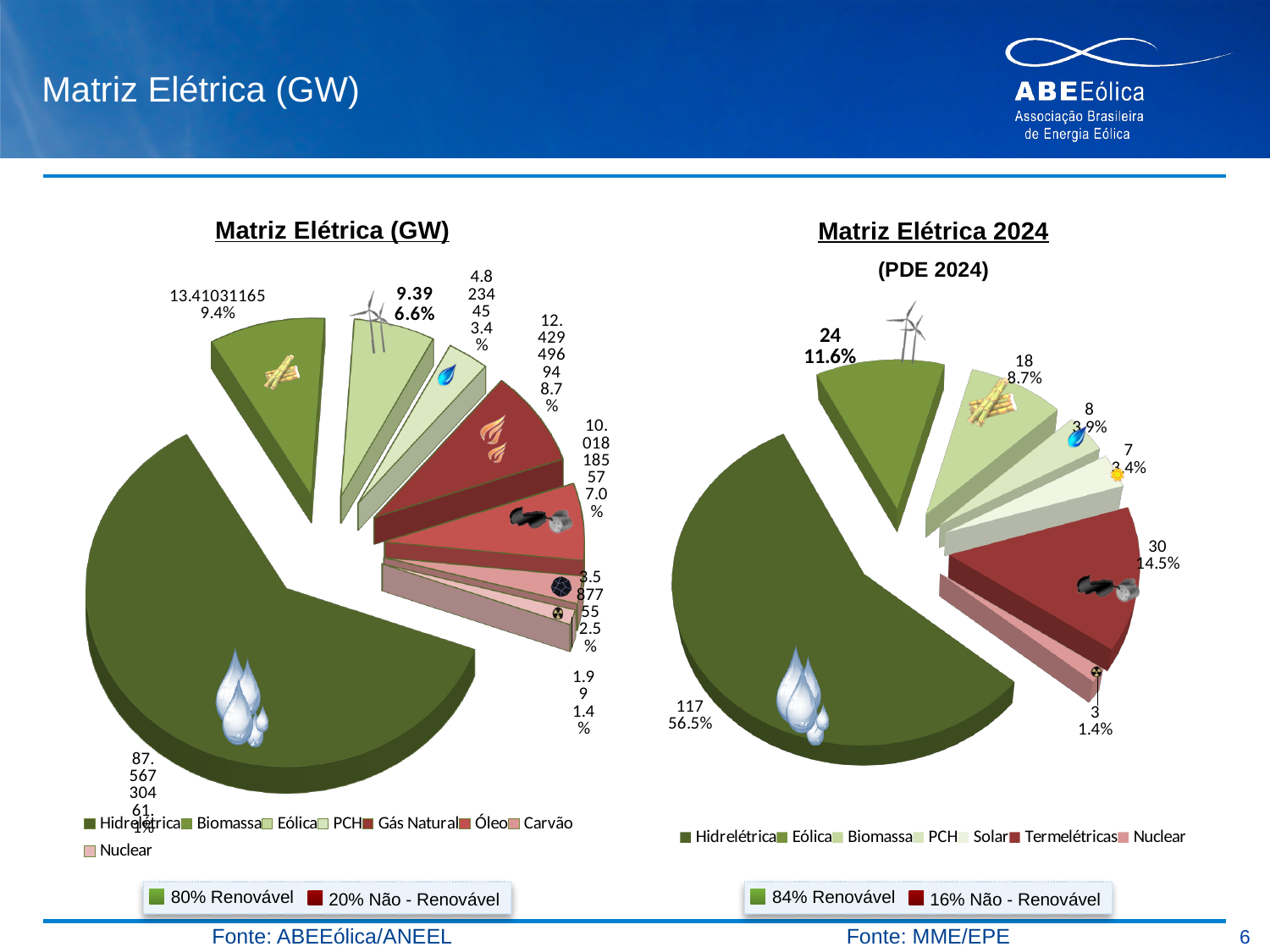
In the 'Matriz Elétrica 2024' chart on the right, which is larger, Termelétricas or Biomassa? Termelétricas How many sources are listed in the legend of the 'Matriz Elétrica (GW)' chart on the left? 8 What type of chart is used for 'Matriz Elétrica (GW)' on the left? Pie chart In the 'Matriz Elétrica 2024' chart on the right, what is the difference in GW between Termelétricas (30) and Eólica (24)? 6 In the 'Matriz Elétrica (GW)' chart on the left, what percentage share is shown for Eólica? 6.6% In the 'Matriz Elétrica 2024' chart on the right, what value in GW is shown for Eólica? 24 In the 'Matriz Elétrica (GW)' chart on the left, what percentage share is shown for Gás Natural? 8.7% In the 'Matriz Elétrica 2024' chart on the right, what percentage share does Hidrelétrica have? 56.5% How many sources are listed in the legend of the 'Matriz Elétrica 2024' chart on the right? 7 In the 'Matriz Elétrica 2024' chart on the right, which source has the largest slice? Hidrelétrica In the 'Matriz Elétrica 2024' chart on the right, which source has the smallest slice? Nuclear In the 'Matriz Elétrica (GW)' chart on the left, which has a larger share, Biomassa or Eólica? Biomassa